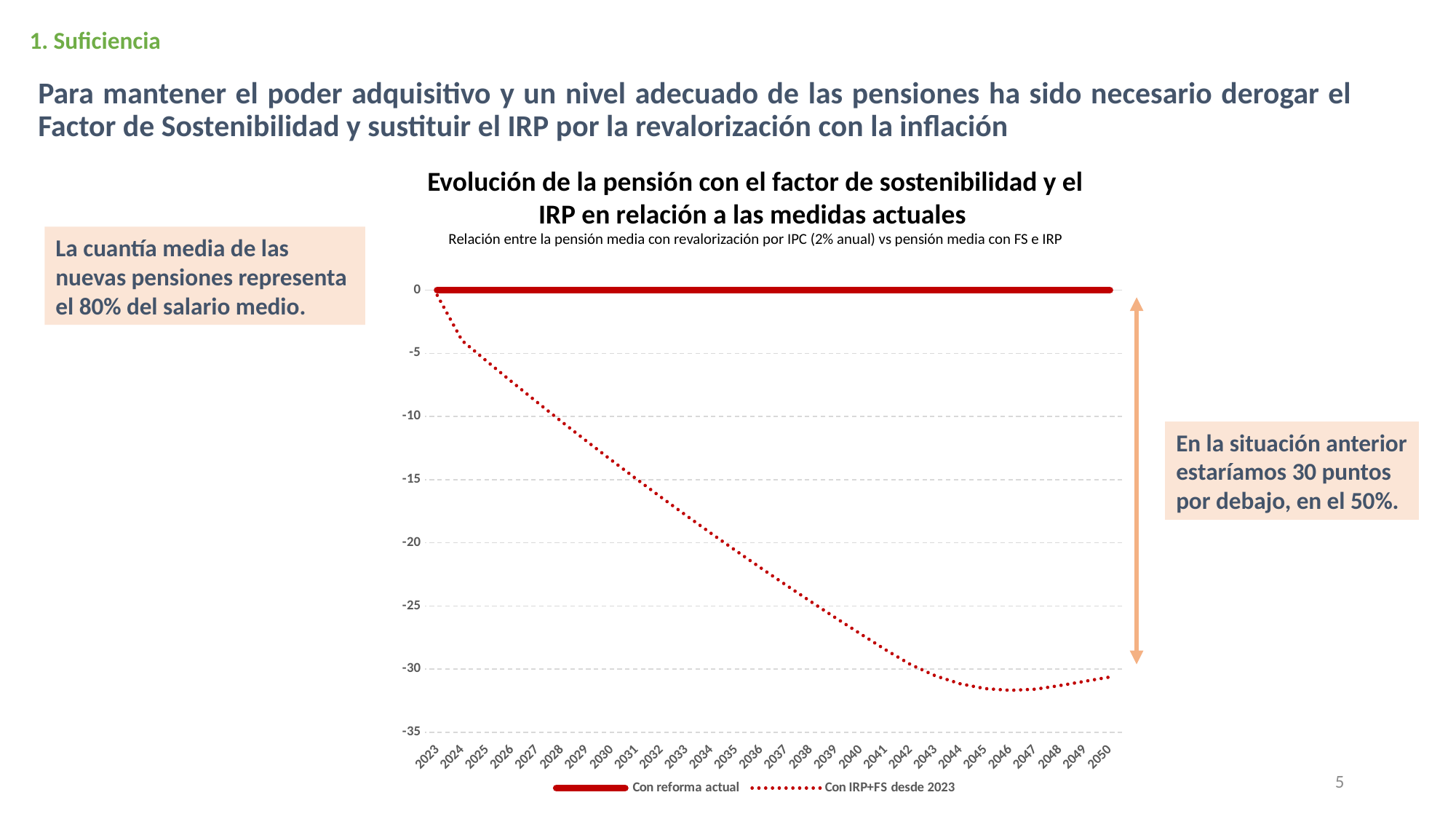
Which series is drawn with a dotted line? Con IRP+FS desde 2023 What kind of chart is shown on the slide? line chart Does the 'Con IRP+FS desde 2023' series rise or fall between 2023 and 2040? fall Is the value for 'Con IRP+FS desde 2023' in 2040 greater or less than -25? less Is the value for 'Con IRP+FS desde 2023' in 2045 greater or less than -30? less Is the value for 'Con IRP+FS desde 2023' in 2026 greater or less than -10? greater How many years are shown on the x axis? 28 In 2040, which series has the higher value, 'Con reforma actual' or 'Con IRP+FS desde 2023'? Con reforma actual What is the value of the 'Con reforma actual' series in 2040? 0 How many series does the legend list? 2 What is the first year shown on the x axis? 2023